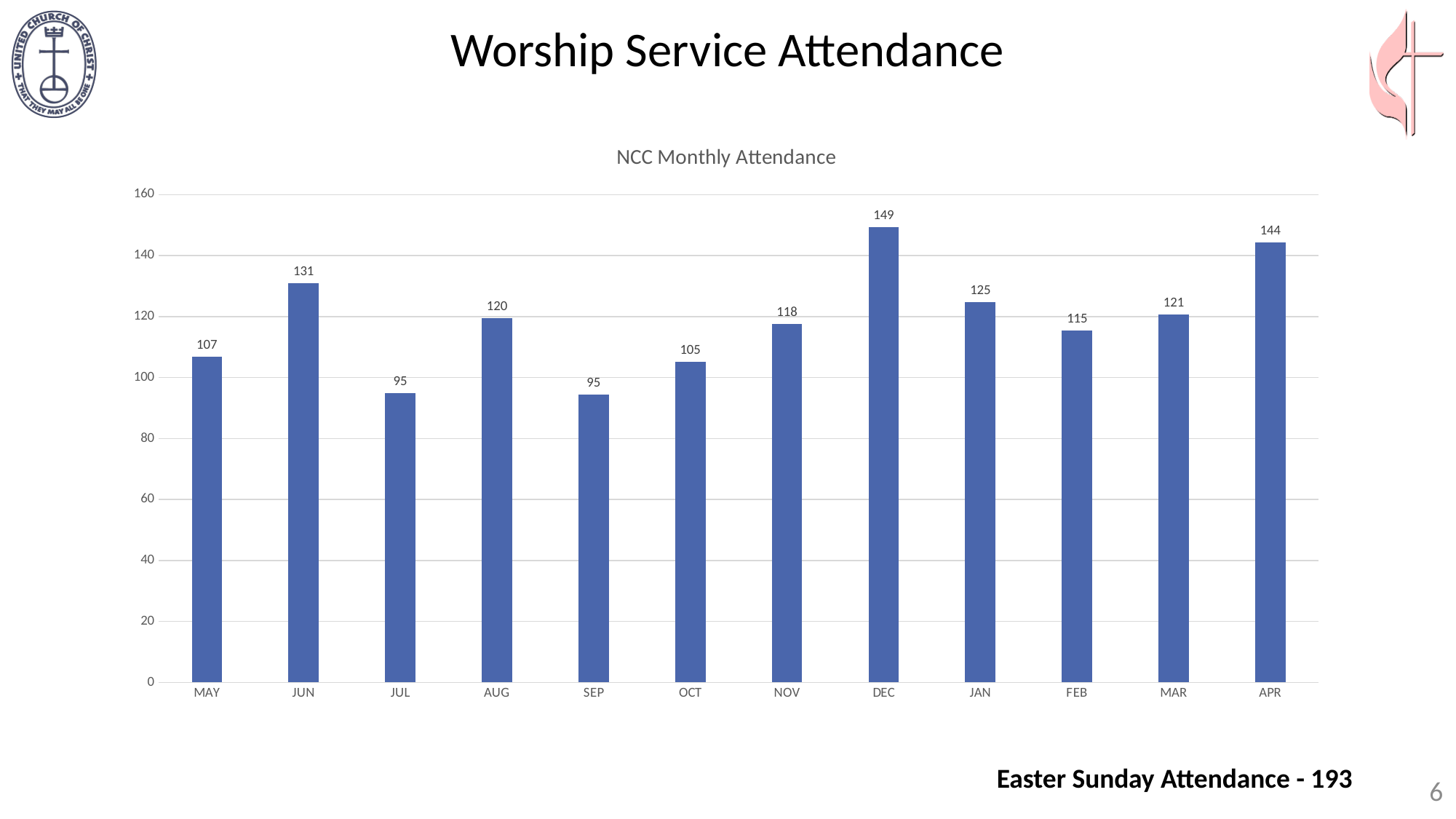
What is the attendance value for DEC? 149 How many months are shown on the x axis? 12 What is the attendance value for FEB? 115 What is the difference between the attendance for DEC and APR? 5 Which month has the highest attendance? DEC What is the attendance value for MAY? 107 Which has a higher attendance, JAN or MAR? JAN What kind of chart is shown on the slide? Bar chart What is the difference between the attendance for JUN and JUL? 36 What is the title of the chart? NCC Monthly Attendance Is the value for OCT greater or less than 100? greater Which months share the lowest attendance value? JUL and SEP